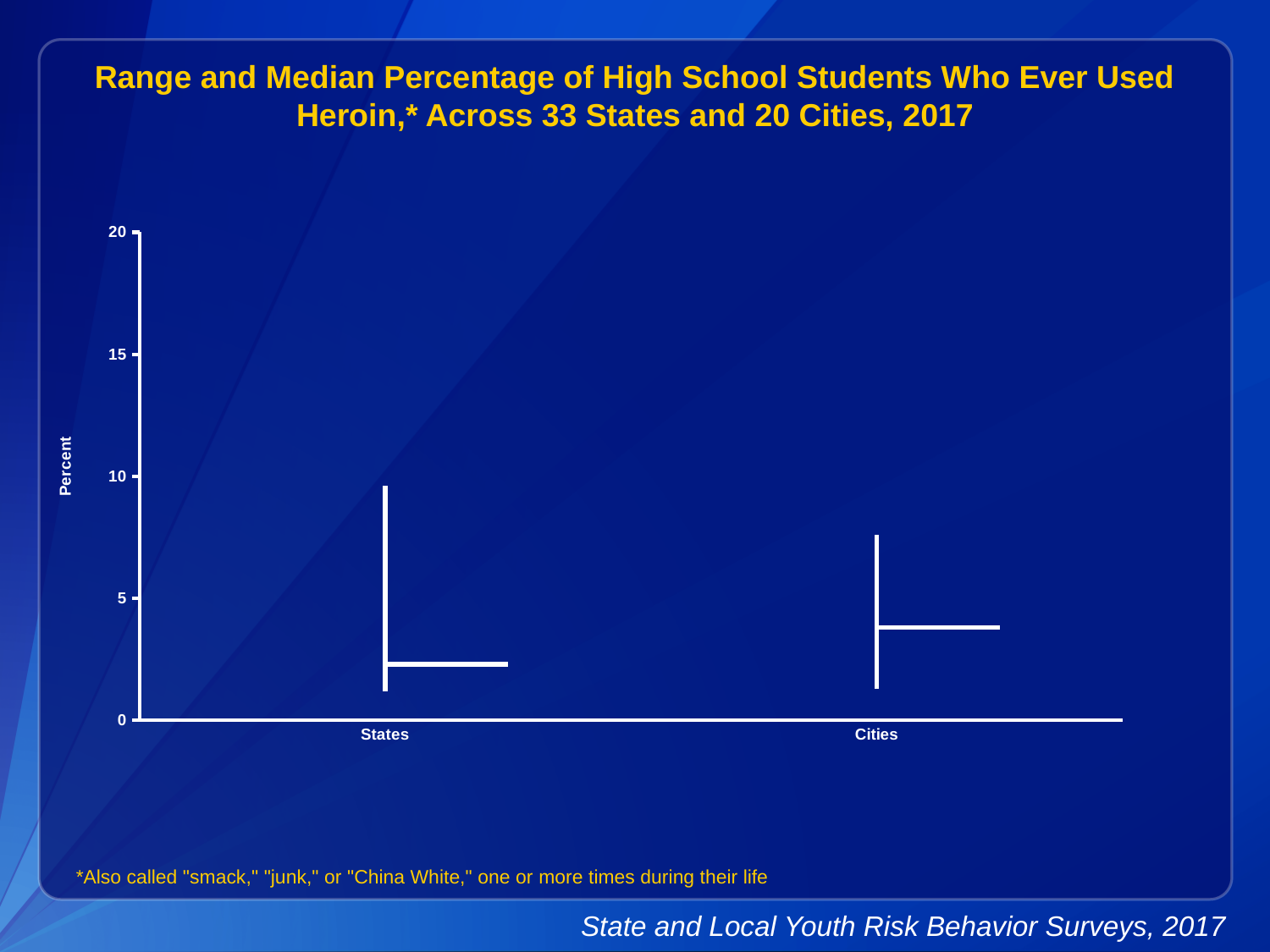
Which category has the higher top of its range, States or Cities? States What is the label of the y axis? Percent What are the two categories shown on the x axis? States and Cities Is the top of the range for States greater or less than 10? less Is the top of the range for Cities greater or less than 5? greater Is the top of the range for States greater or less than 5? greater Which category has the higher median value, States or Cities? Cities What is the highest value shown on the y axis? 20 How many categories are shown on the x axis of the chart? 2